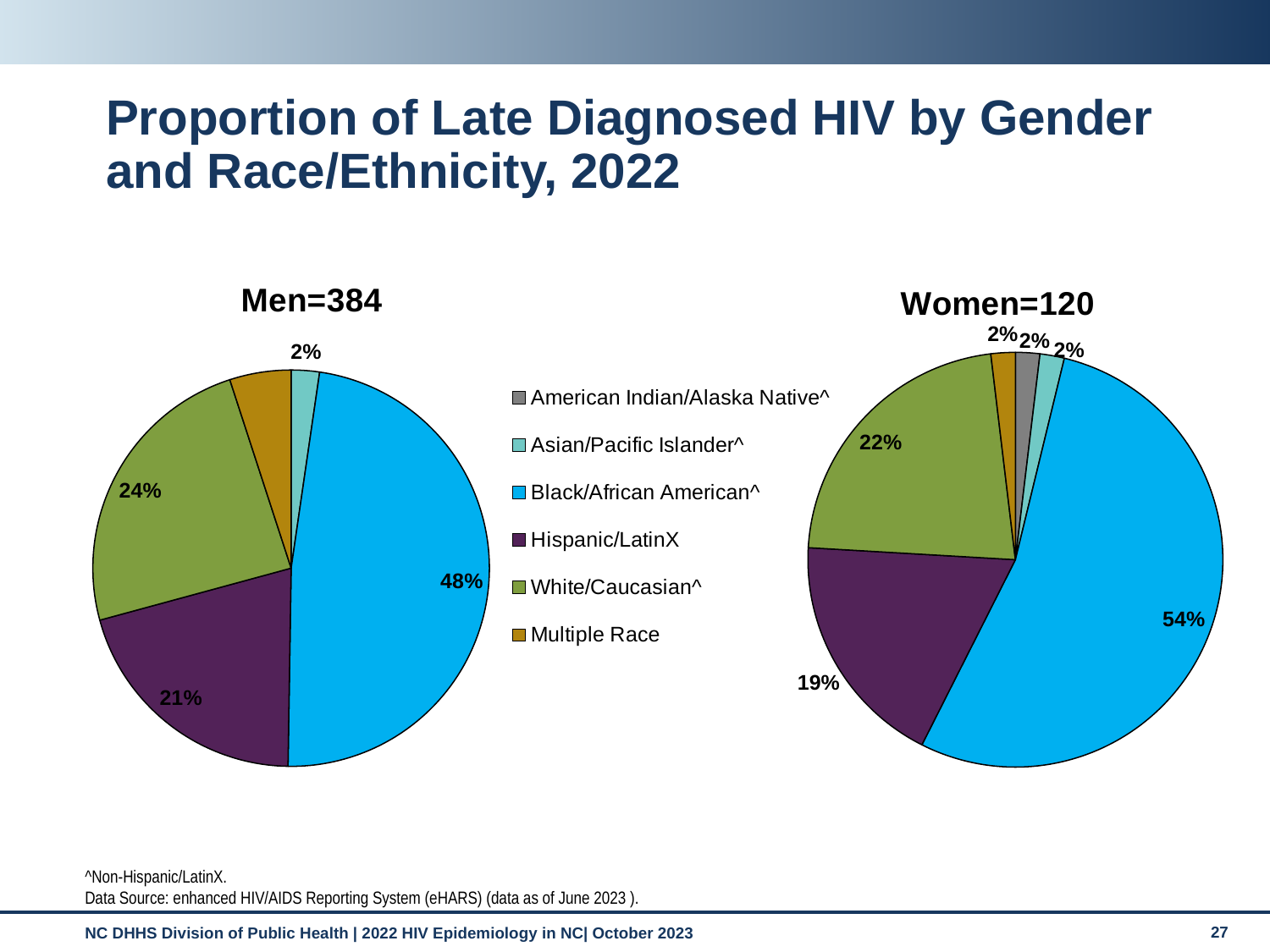
What type of charts are shown on the slide? Pie charts In the Women=120 pie chart, what percentage is Hispanic/LatinX? 19% In the Men=384 pie chart, which race/ethnicity has the largest share? Black/African American^ In the Women=120 pie chart, which race/ethnicity has the largest share? Black/African American^ How many race/ethnicity categories does the legend list? 6 In the Women=120 pie chart, what percentage is Black/African American^? 54% In the Men=384 pie chart, what percentage is White/Caucasian^? 24% In the Men=384 pie chart, which is larger: the White/Caucasian^ share or the Hispanic/LatinX share? White/Caucasian^ In the Women=120 pie chart, what percentage is White/Caucasian^? 22% In the Men=384 pie chart, what percentage is Black/African American^? 48% What is the difference between the Black/African American^ share in the Women=120 chart and in the Men=384 chart? 6% In the Men=384 pie chart, what percentage is Hispanic/LatinX? 21%